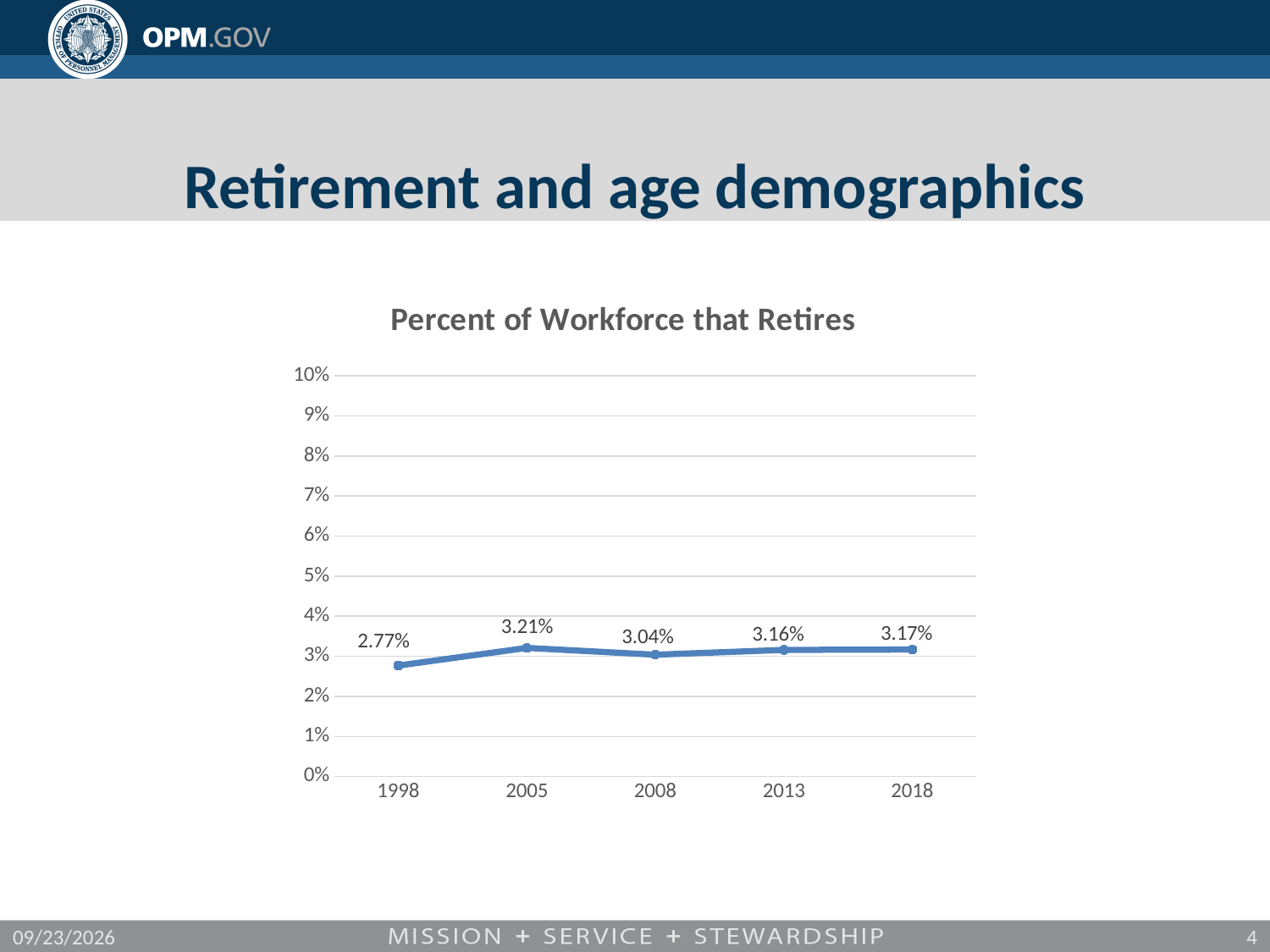
What is the difference between the 2005 value and the 1998 value? 0.44% What kind of chart is shown on the slide? line chart Which year has the lowest percent of workforce that retires? 1998 Does the value rise or fall from 1998 to 2005? rise Is the value for 1998 greater or less than 3%? less How many years are plotted on the chart? 5 What is the percent of workforce that retires in 2005? 3.21% What is the percent of workforce that retires in 2018? 3.17% Which is larger, the value for 2008 or the value for 2013? 2013 Which year has the highest percent of workforce that retires? 2005 What is the percent of workforce that retires in 1998? 2.77% What is the title of the chart? Percent of Workforce that Retires